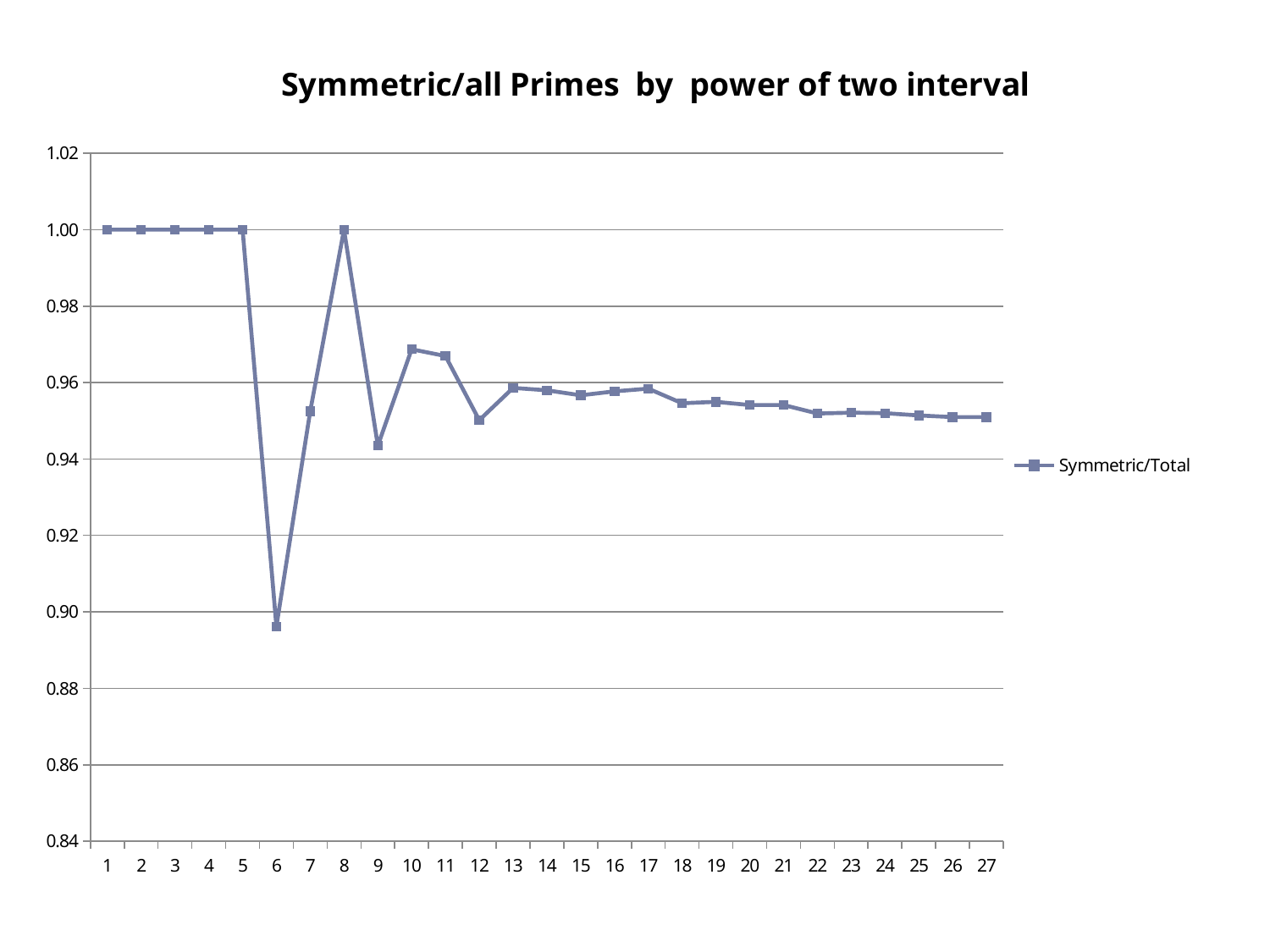
What is the Symmetric/Total value at interval 1? 1.00 What kind of chart is shown on the slide? line chart Is the Symmetric/Total value at interval 6 greater or less than 0.90? less How many series does the legend list? 1 At which x-axis interval is the Symmetric/Total value lowest? 6 Do the Symmetric/Total values rise or fall from interval 17 to interval 27? fall How many points are plotted along the x axis? 27 Which has the larger Symmetric/Total value, interval 9 or interval 10? interval 10 Is the Symmetric/Total value at interval 10 greater or less than 0.96? greater What is the name of the series shown in the legend? Symmetric/Total What is the Symmetric/Total value at interval 8? 1.00 What is the title of the chart? Symmetric/all Primes by power of two interval